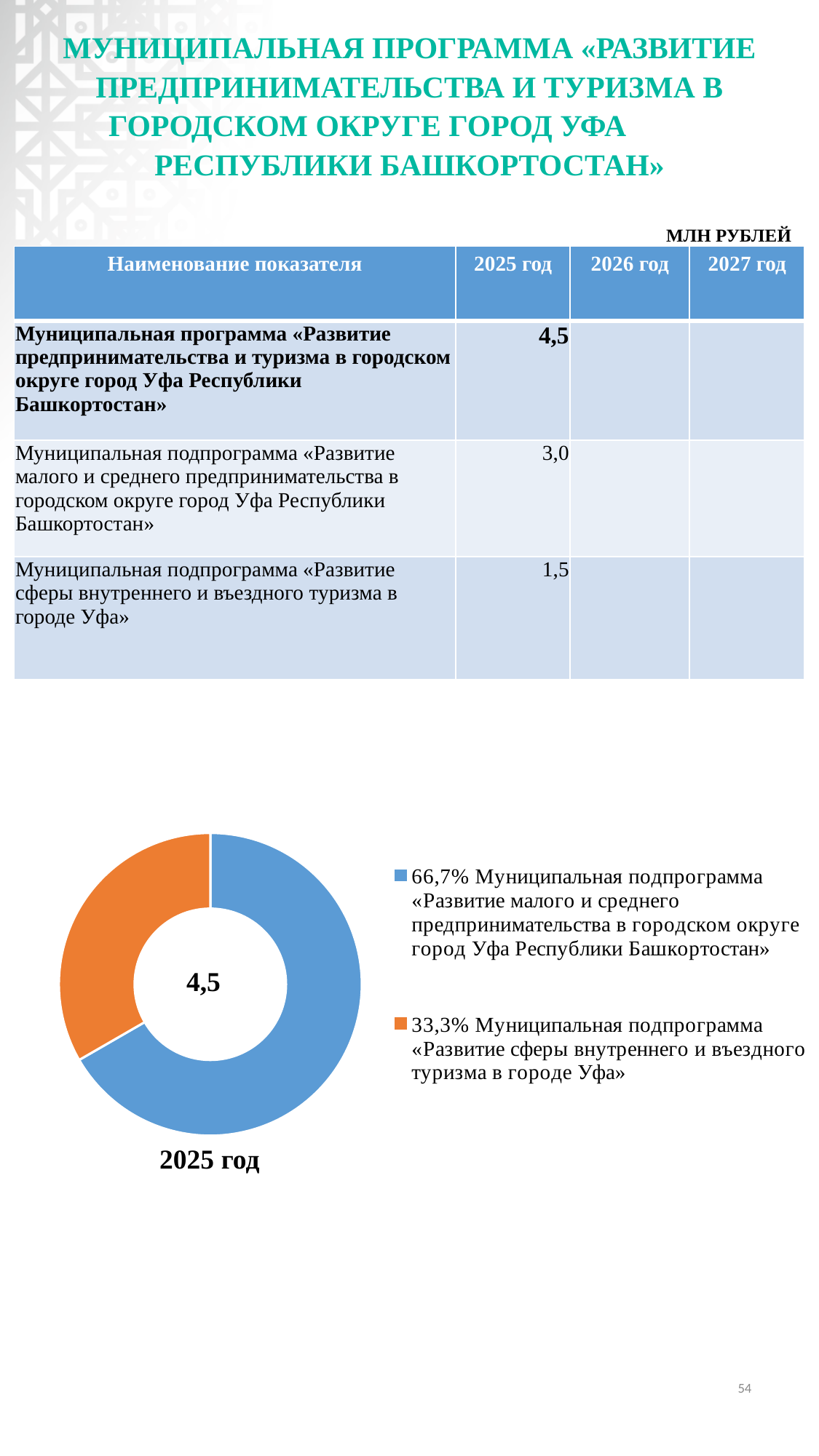
What value is printed in the centre of the doughnut chart? 4,5 What share of the doughnut chart is the subprogramme «Развитие сферы внутреннего и въездного туризма в городе Уфа»? 33,3% Which is larger in the doughnut chart: the share for small and medium business development or the share for tourism development? small and medium business development Which slice of the doughnut chart is the smallest? Муниципальная подпрограмма «Развитие сферы внутреннего и въездного туризма в городе Уфа» Which slice of the doughnut chart is the largest? Муниципальная подпрограмма «Развитие малого и среднего предпринимательства в городском округе город Уфа Республики Башкортостан» What share of the doughnut chart is the subprogramme «Развитие малого и среднего предпринимательства в городском округе город Уфа Республики Башкортостан»? 66,7% How many entries does the legend of the doughnut chart list? 2 What is the difference in percentage points between the two slices of the doughnut chart? 33,4 Which year is the doughnut chart labelled with? 2025 год How many slices does the doughnut chart have? 2 What colour is the slice for the tourism development subprogramme in the doughnut chart? orange What kind of chart is shown on the slide? doughnut chart